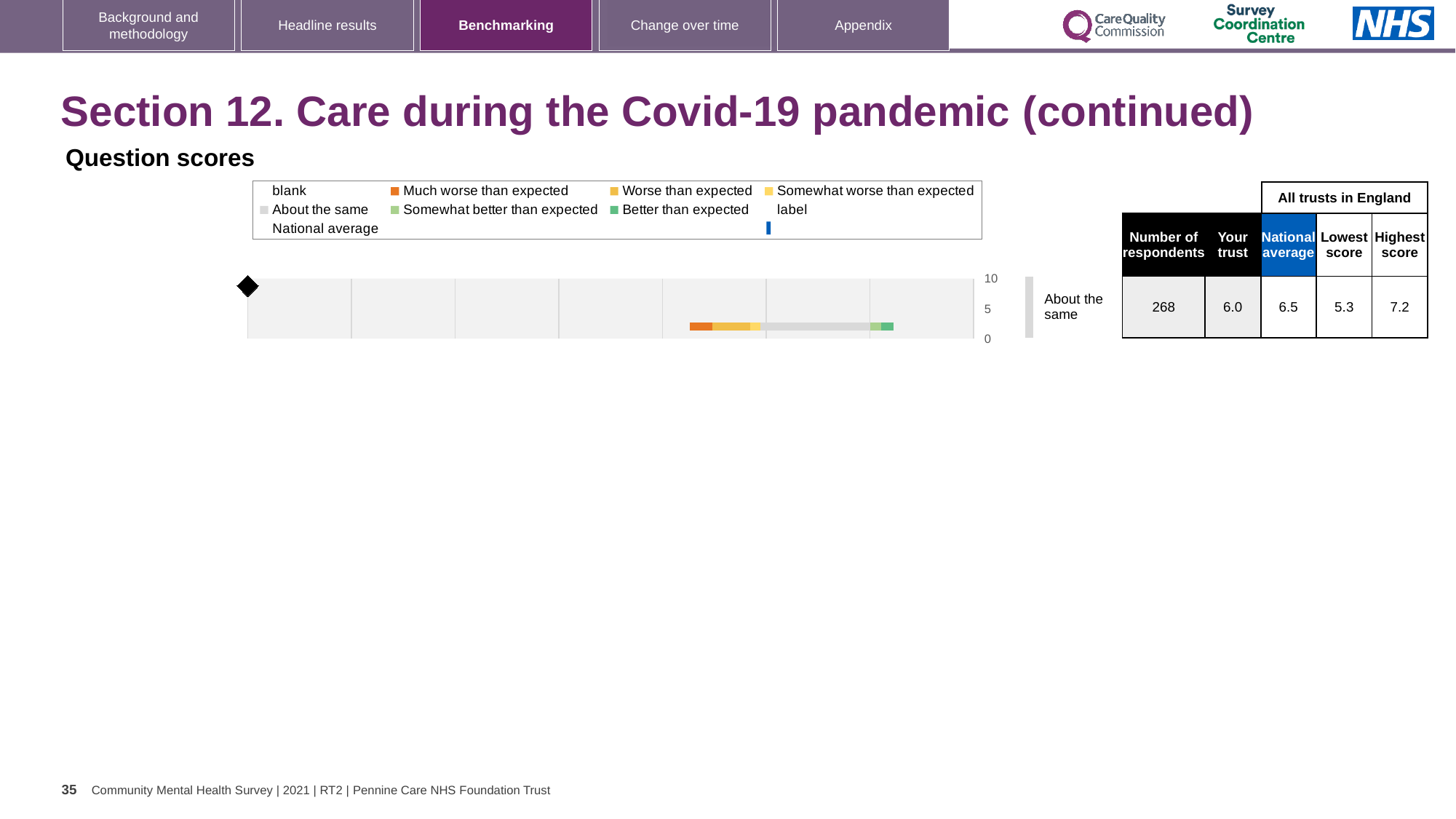
What is the maximum value shown on the chart's axis? 10 What is the difference between the highest score and the lowest score for the 'About the same' question? 1.9 What is the 'Your trust' score for the 'About the same' question? 6.0 What kind of chart is shown under the heading 'Question scores'? bar chart How many respondents answered the 'About the same' question? 268 Which is larger for the 'About the same' question, the 'Your trust' score or the national average? National average How many question categories are plotted in the chart? 1 What is the national average score for the 'About the same' question? 6.5 Which legend entry is shown in orange? Much worse than expected What is the lowest score among all trusts in England for the 'About the same' question? 5.3 What is the difference between the national average and the 'Your trust' score for the 'About the same' question? 0.5 What is the highest score among all trusts in England for the 'About the same' question? 7.2